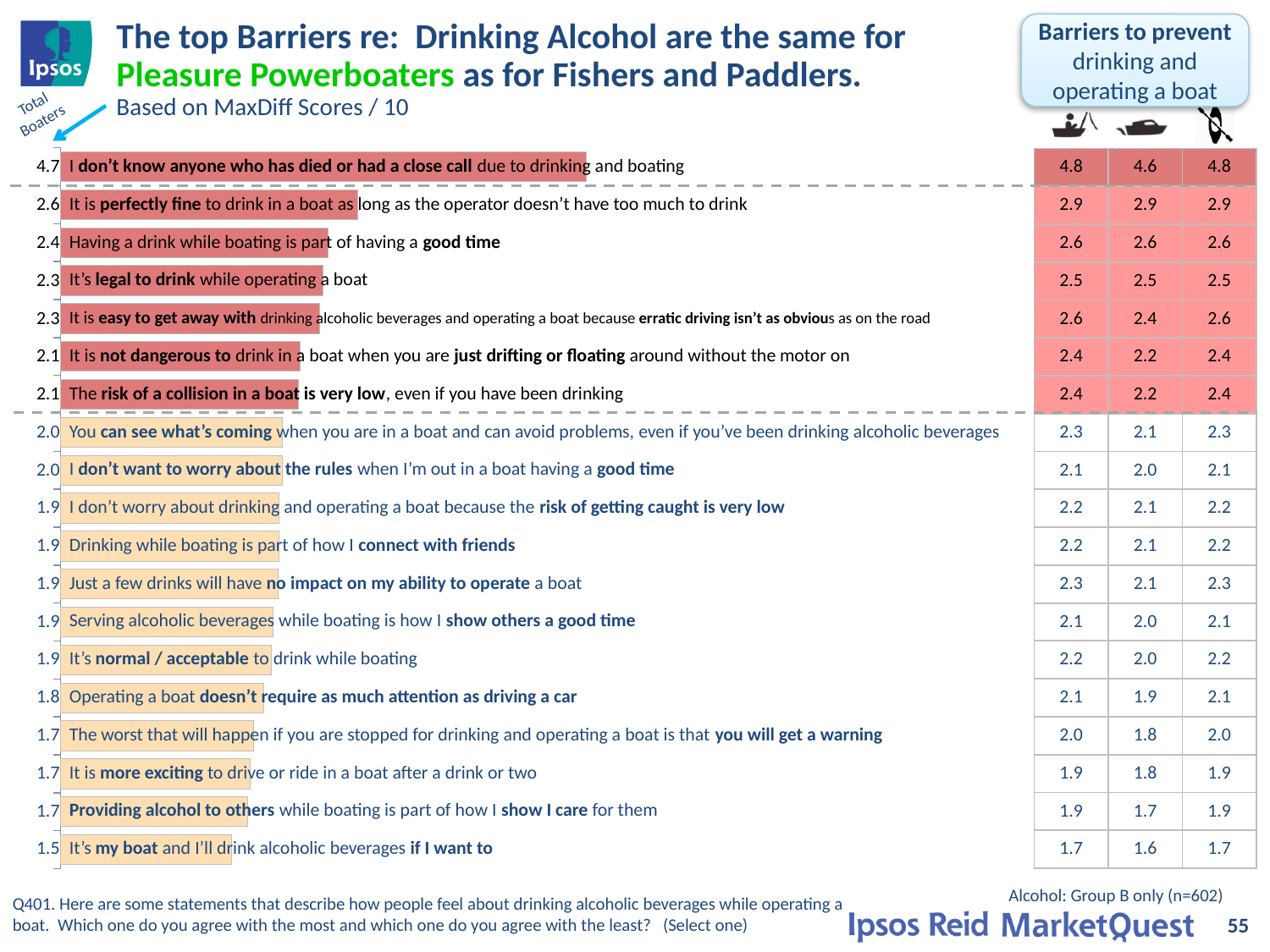
Which statement has the highest Total Boaters score? I don't know anyone who has died or had a close call due to drinking and boating How many statements (bars) are shown in the chart? 19 Which has a higher Total Boaters score: "It's legal to drink while operating a boat" or "Operating a boat doesn't require as much attention as driving a car"? It's legal to drink while operating a boat What kind of chart is shown on the slide? bar chart What scores does the subtitle say the chart is based on? MaxDiff Scores / 10 Which statement has the lowest Total Boaters score? It's my boat and I'll drink alcoholic beverages if I want to What is the Total Boaters score for "It's legal to drink while operating a boat"? 2.3 How many bars are shaded red (above the dashed line) rather than orange? 7 What is the Total Boaters score for "Operating a boat doesn't require as much attention as driving a car"? 1.8 What is the Total Boaters score for "It's my boat and I'll drink alcoholic beverages if I want to"? 1.5 What is the difference between the Total Boaters scores for "I don't know anyone who has died or had a close call" and "It is perfectly fine to drink in a boat as long as the operator doesn't have too much to drink"? 2.1 What is the Total Boaters MaxDiff score for "I don't know anyone who has died or had a close call due to drinking and boating"? 4.7